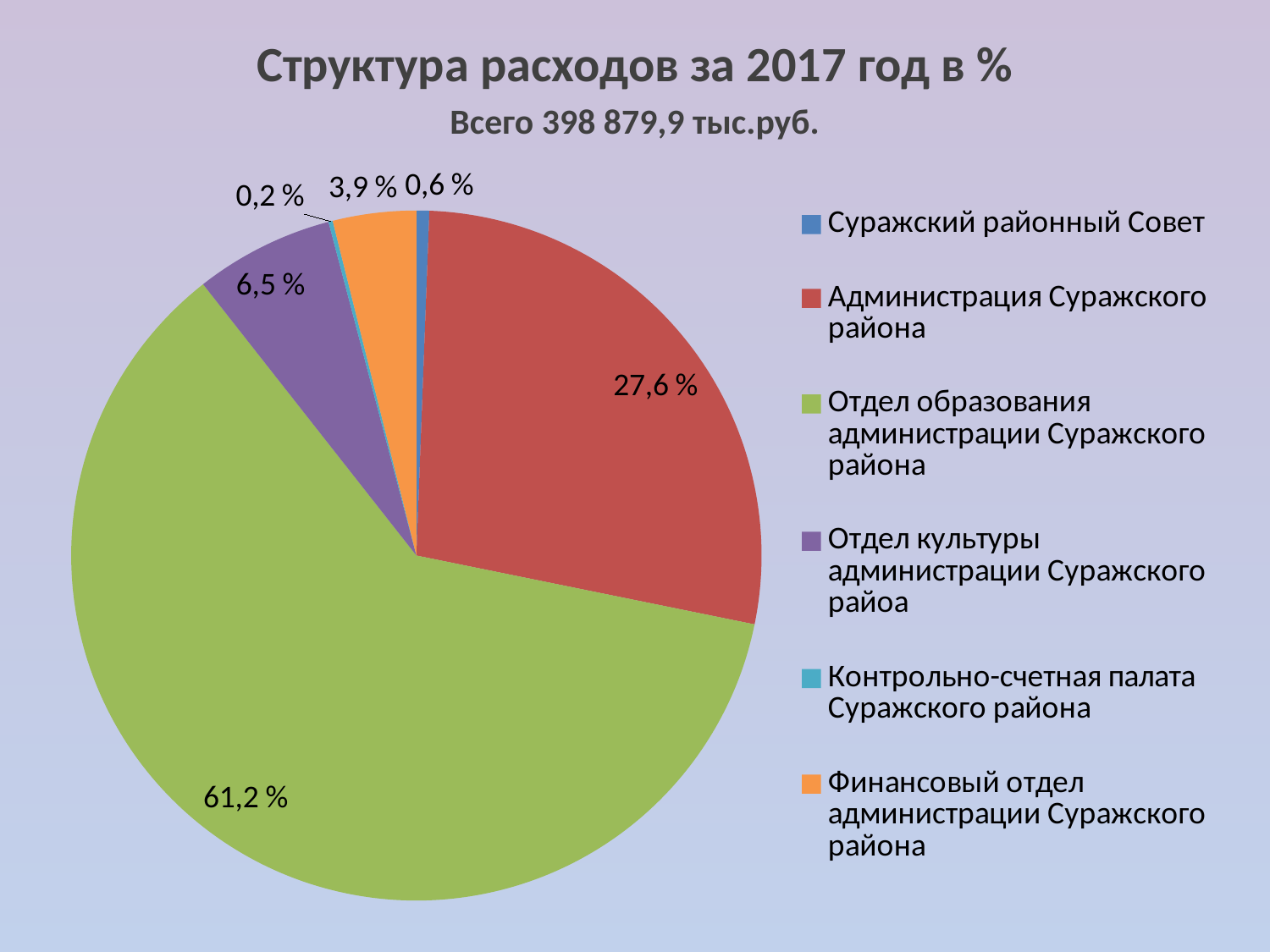
How many categories does the legend list? 6 What is the share for Отдел культуры администрации Суражского райоа? 6,5 % What is the share for Администрация Суражского района? 27,6 % What total amount is stated in the chart subtitle? 398 879,9 тыс.руб. What is the share for Суражский районный Совет? 0,6 % What is the difference between the shares of Отдел образования администрации Суражского района and Администрация Суражского района? 33,6 % What is the share for Отдел образования администрации Суражского района? 61,2 % What is the share for Контрольно-счетная палата Суражского района? 0,2 % Which category has the smallest share of the pie? Контрольно-счетная палата Суражского района What is the share for Финансовый отдел администрации Суражского района? 3,9 % Which category has the largest share of the pie? Отдел образования администрации Суражского района What type of chart is shown on the slide? pie chart